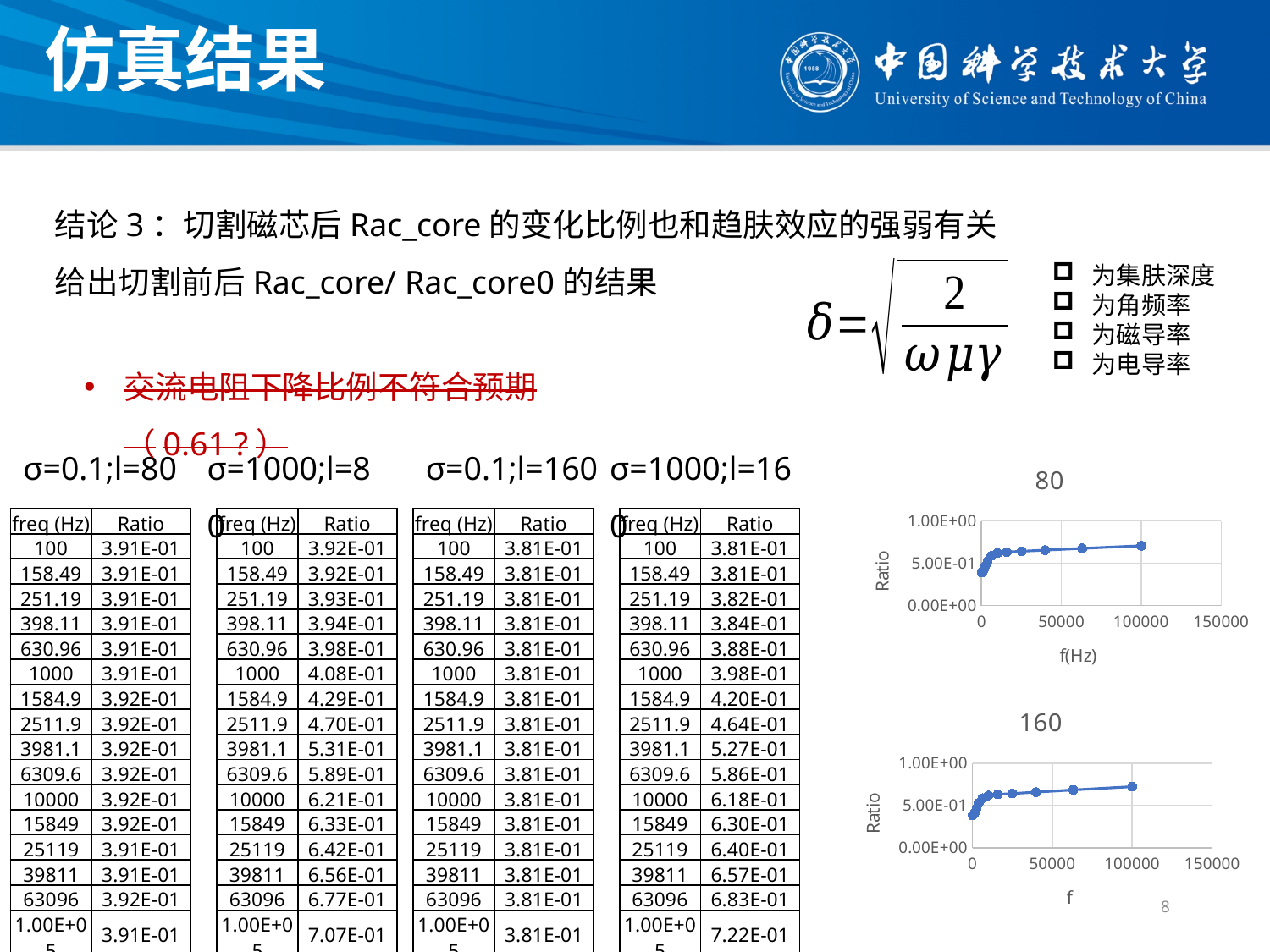
In the chart titled "160", which has the larger Ratio: the point at f = 100000 or the point at the lowest frequency? the point at f = 100000 In the chart titled "160", is the Ratio value at f = 100000 greater or less than 5.00E-01? greater How many charts are shown on the slide? 2 What is the y-axis label of the chart titled "80"? Ratio What is the title of the lower chart on the right side of the slide? 160 In the chart titled "160", do the Ratio values rise or fall as f increases? rise In the chart titled "80", is the Ratio value at f = 100000 greater or less than 5.00E-01? greater In the chart titled "80", do the Ratio values rise or fall as f(Hz) increases? rise In the chart titled "80", is the Ratio value at f = 100000 greater or less than 1.00E+00? less What kind of chart is the chart titled "80"? line chart